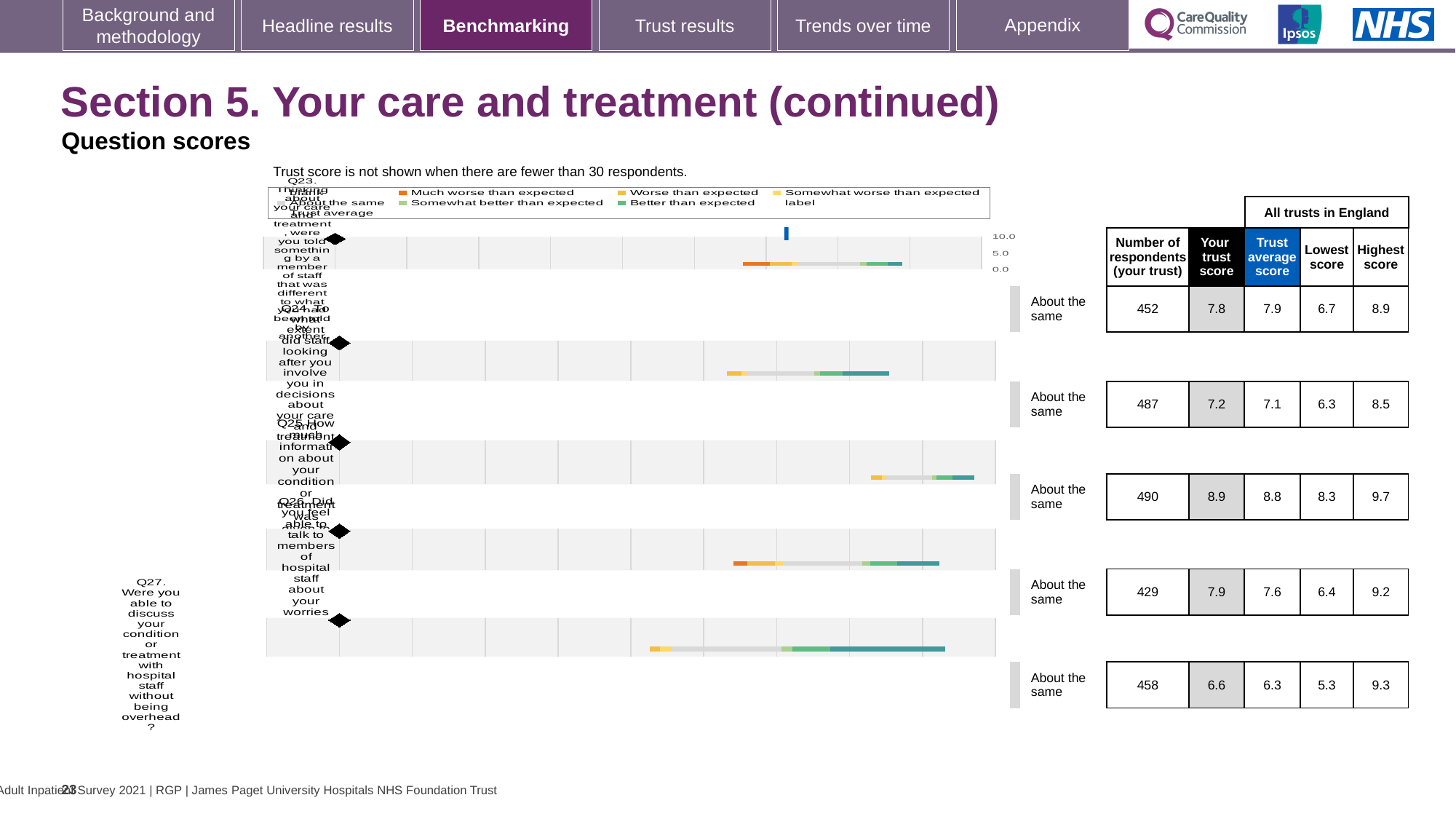
How many respondents are listed for Q26? 429 How many questions (Q23 to Q27) are plotted in the chart? 5 For Q26, which is larger: the 'Your trust score' or the trust average score? Your trust score According to the note above the chart, when is the trust score not shown? When there are fewer than 30 respondents For Q23, what is the difference between the highest score and the lowest score across all trusts in England? 2.2 What is the trust average score for Q27? 6.3 What is the 'Your trust score' value for Q24? 7.2 What is the highest score across all trusts in England for Q27? 9.3 What benchmark category is shown next to the bar for Q25? About the same Which question has the highest 'Your trust score'? Q25 Which question has the lowest 'Your trust score'? Q27 What kind of chart is used to show the question scores on this slide? bar chart